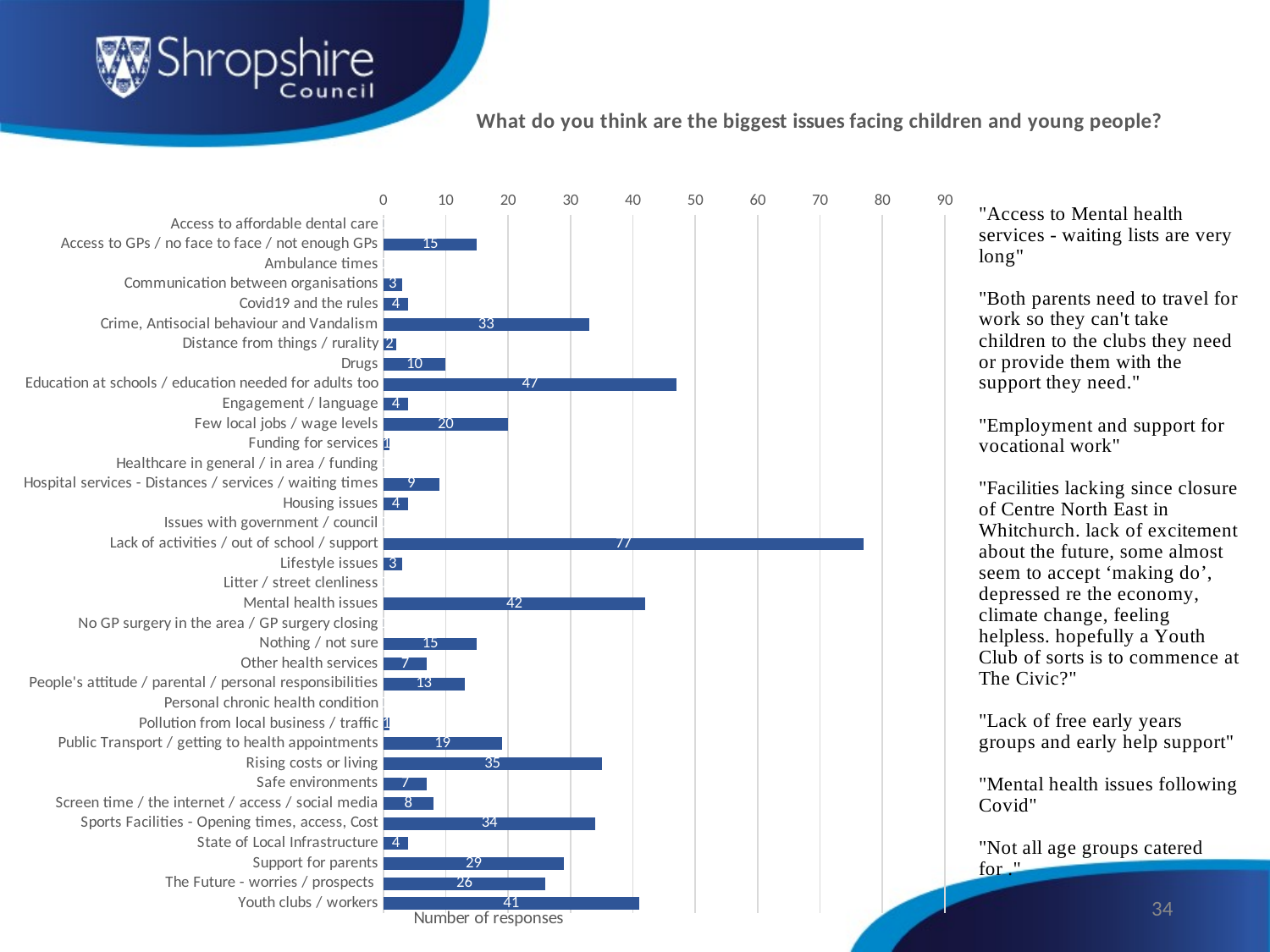
What is the difference between the values for 'Education at schools / education needed for adults too' and 'Mental health issues'? 5 How many responses are shown for 'Lack of activities / out of school / support'? 77 What is the value for 'Youth clubs / workers'? 41 What question does the slide title say the chart is about? What do you think are the biggest issues facing children and young people? What is the label on the horizontal axis of the chart? Number of responses What is the value for 'Mental health issues'? 42 Which has more responses: 'Crime, Antisocial behaviour and Vandalism' or 'Sports Facilities - Opening times, access, Cost'? Sports Facilities - Opening times, access, Cost What is the difference between the values for 'Few local jobs / wage levels' and 'Drugs'? 10 Which category has the highest number of responses? Lack of activities / out of school / support What type of chart is shown on the slide? Bar chart Is the value for 'Support for parents' greater or less than 20? greater What is the value for 'Rising costs or living'? 35